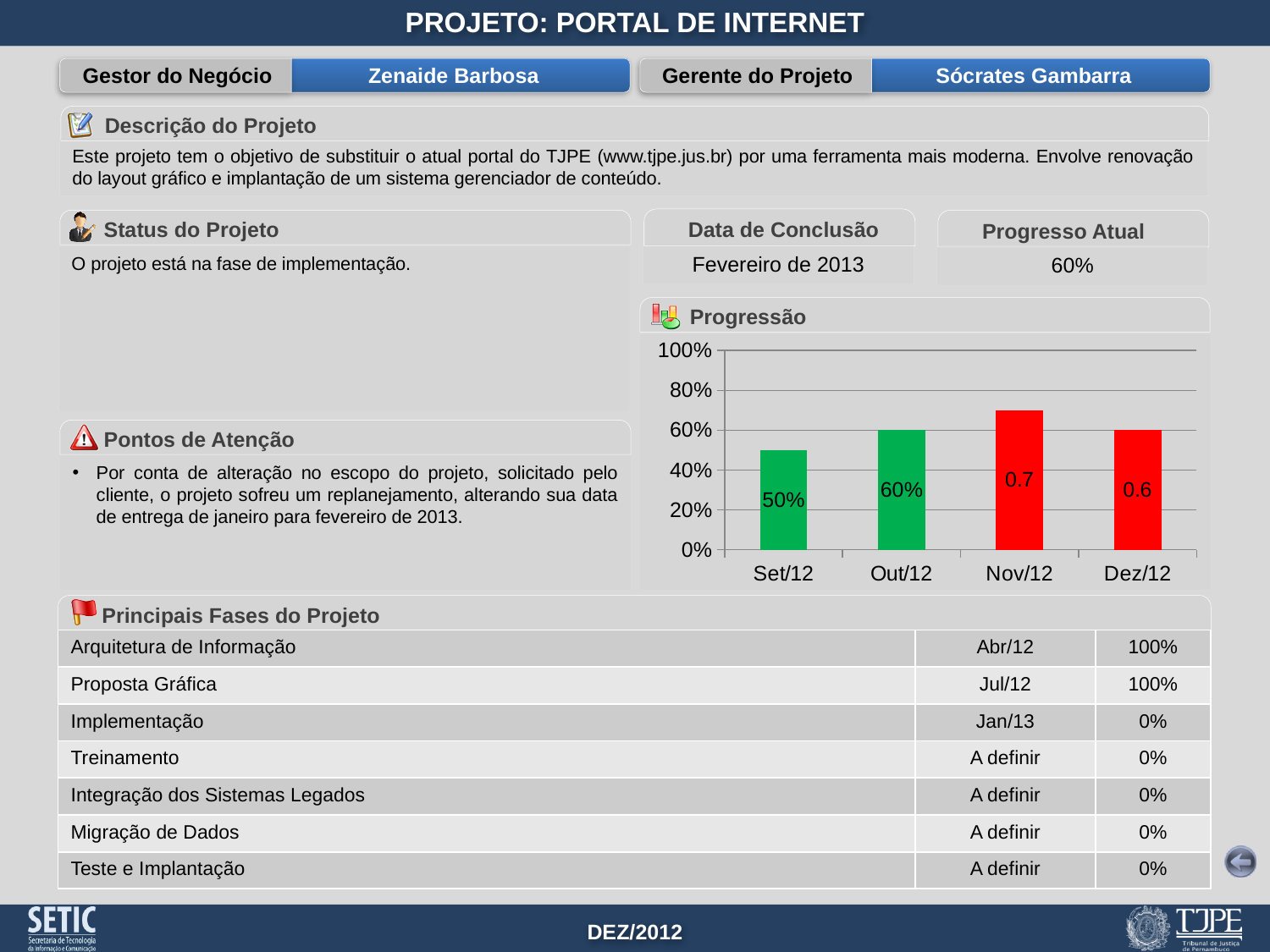
What is the value shown for Set/12 in the Progressão chart? 50% Which is larger in the Progressão chart, the value for Out/12 or the value for Nov/12? Nov/12 What colour are the Nov/12 and Dez/12 bars in the Progressão chart? red What is the data label shown on the Nov/12 bar in the Progressão chart? 0.7 What is the difference between the values for Out/12 and Set/12 in the Progressão chart? 10% Is the value for Nov/12 in the Progressão chart greater or less than 60%? greater What kind of chart is the Progressão chart? bar chart What is the value shown for Out/12 in the Progressão chart? 60% Which month has the lowest bar in the Progressão chart? Set/12 Which month has the highest bar in the Progressão chart? Nov/12 What is the data label shown on the Dez/12 bar in the Progressão chart? 0.6 How many months are shown on the x axis of the Progressão chart? 4